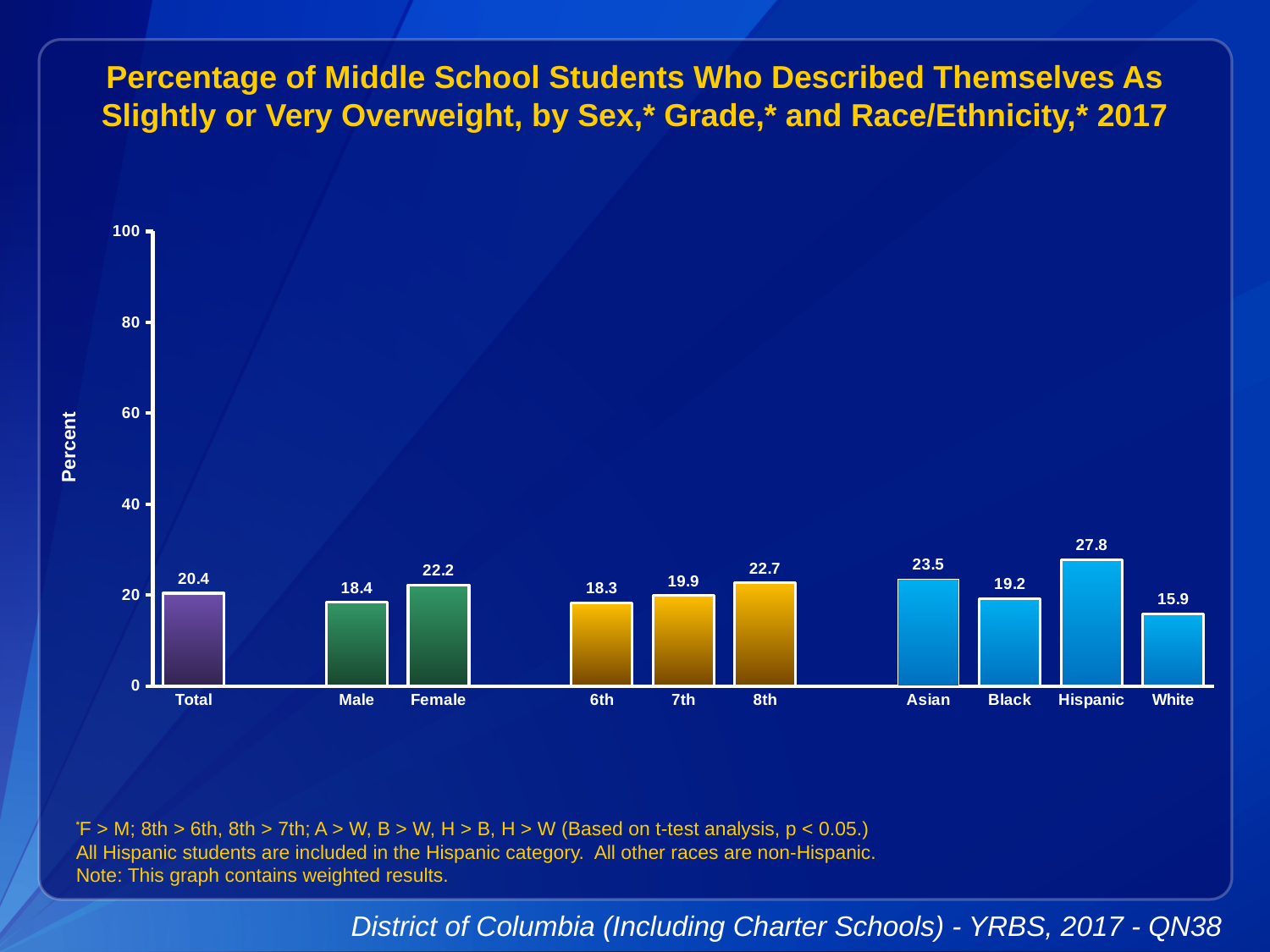
What is the value for Total? 20.4 How many bars are shown on the chart? 10 What is the difference between the Hispanic and White values? 11.9 What is the value for 8th grade students? 22.7 What is the difference between the Female and Male values? 3.8 What kind of chart is shown on the slide? bar chart Which is larger, the value for Asian or the value for Black? Asian Which category has the highest value on the chart? Hispanic Do the values rise or fall from 6th grade to 8th grade? rise Is the value for 7th grade greater or less than 20? less What percentage of female students described themselves as slightly or very overweight? 22.2 Which category has the lowest value on the chart? White